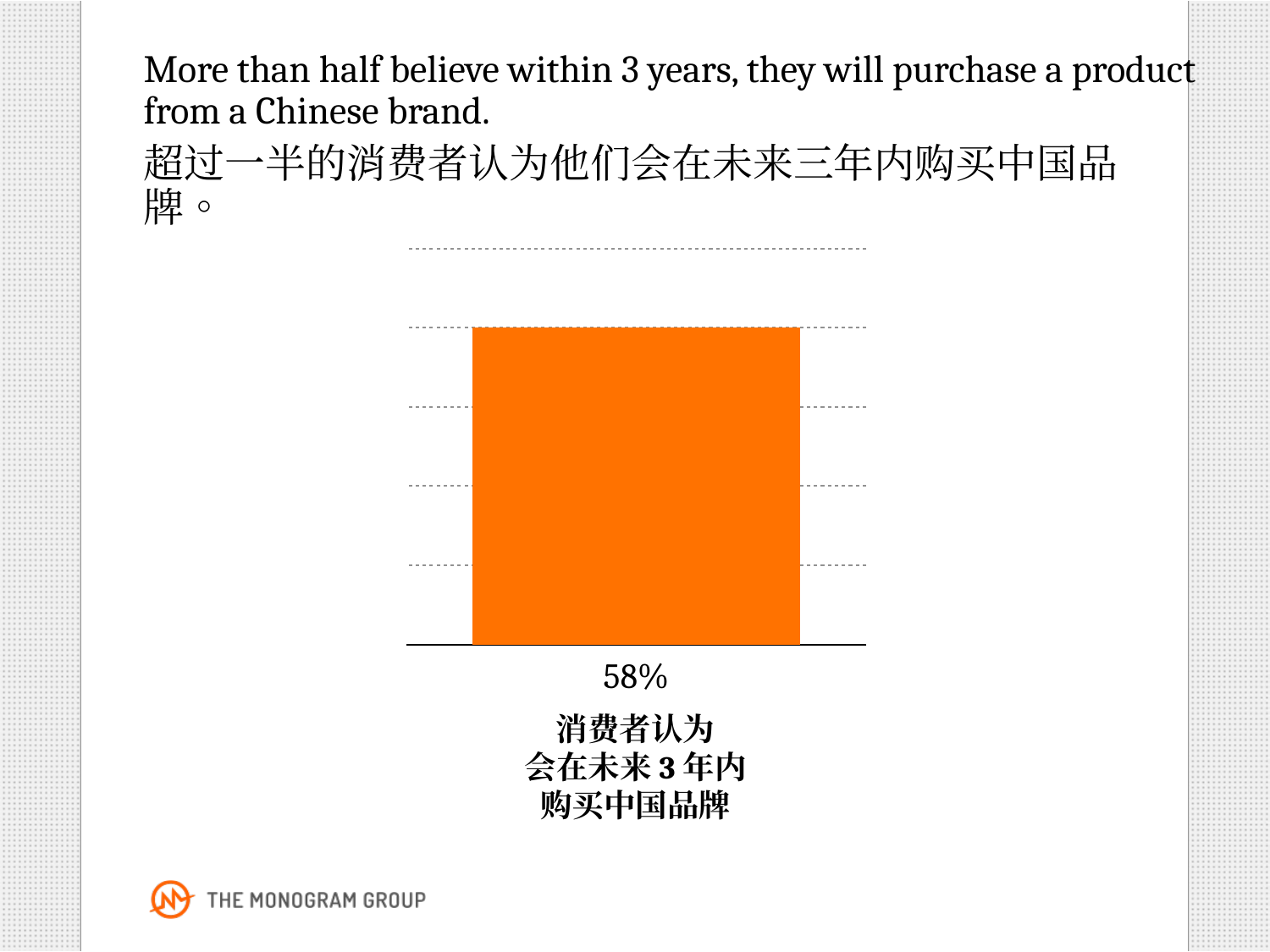
How many bars does the chart show? 1 What value is printed below the bar in the chart? 58% What is the category label under the bar in the chart? 消费者认为会在未来3年内购买中国品牌 What colour is the bar in the chart? Orange What kind of chart is shown on the slide? Bar chart What percentage of consumers believe they will purchase a Chinese brand within the next 3 years, according to the bar chart? 58%